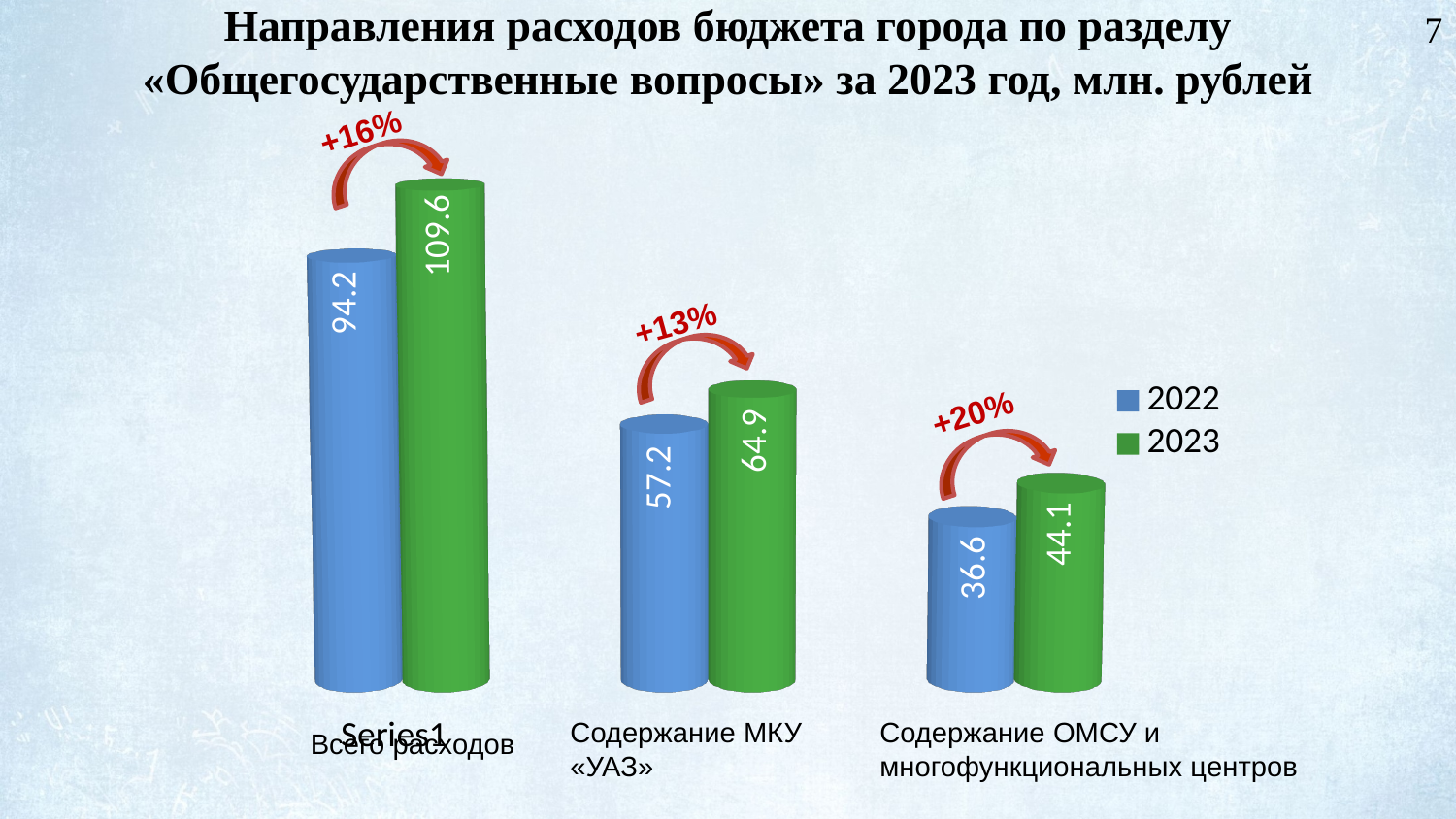
What percentage change is annotated above the bars for «Всего расходов»? +16% What kind of chart is shown on the slide? Bar chart What is the value for 2022 for «Содержание МКУ «УАЗ»»? 57.2 Which category has the lowest value for 2022? Содержание ОМСУ и многофункциональных центров What is the difference between the 2023 and 2022 values for «Содержание МКУ «УАЗ»»? 7.7 Which is larger for «Содержание ОМСУ и многофункциональных центров»: the 2022 value or the 2023 value? 2023 Which category has the highest value for 2023? Всего расходов What is the value for 2023 for «Всего расходов»? 109.6 How many series does the legend list? 2 How many categories are shown on the chart? 3 What is the value for 2022 for «Всего расходов»? 94.2 What is the value for 2023 for «Содержание ОМСУ и многофункциональных центров»? 44.1